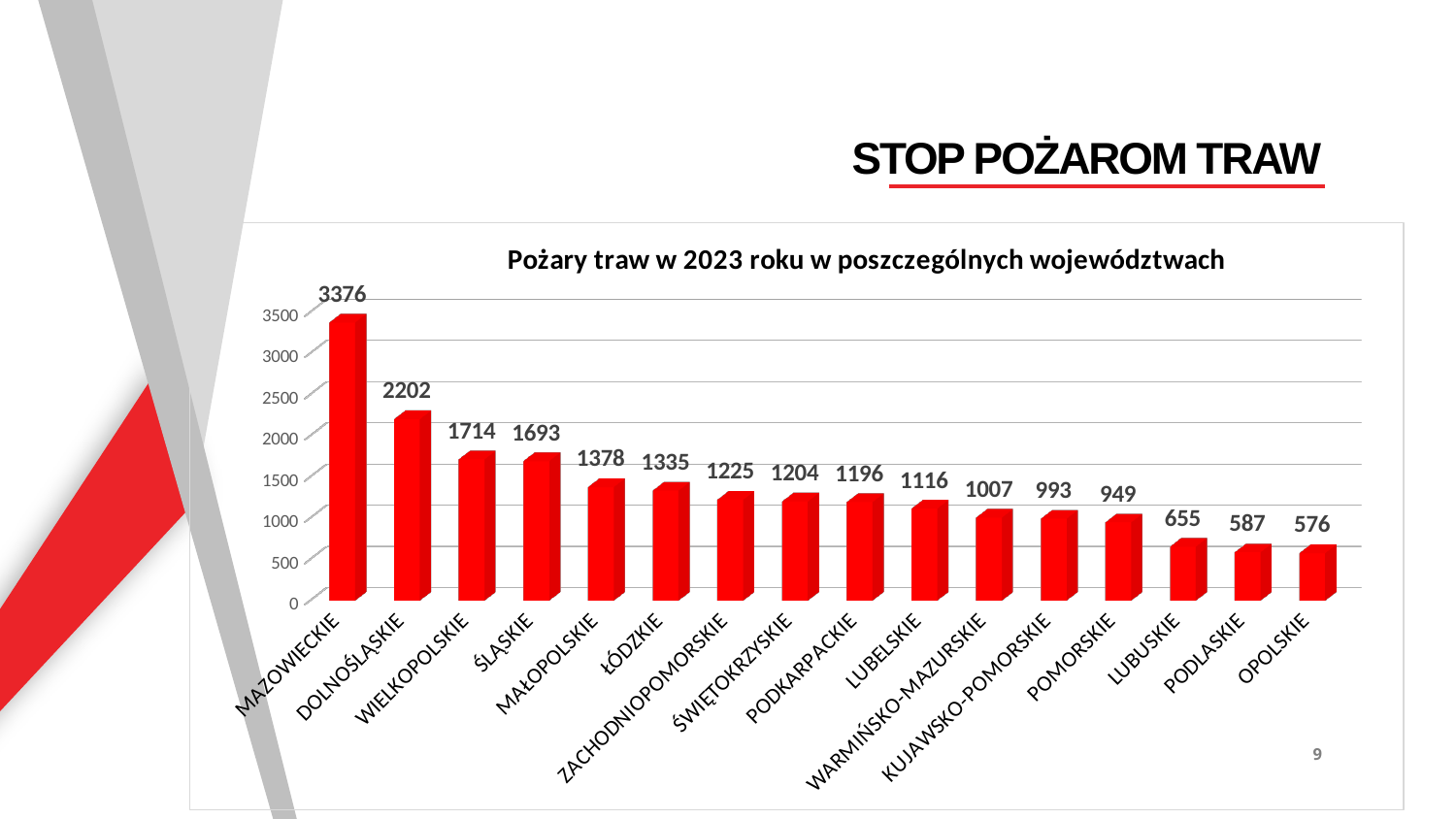
How many voivodeships are shown in the chart? 16 Which voivodeship has the lowest value? OPOLSKIE What is the value for POMORSKIE? 949 Is the value for KUJAWSKO-POMORSKIE greater or less than 1000? less What is the title of the chart? Pożary traw w 2023 roku w poszczególnych województwach Which voivodeship has the highest value? MAZOWIECKIE What is the difference between the values for LUBUSKIE and PODLASKIE? 68 What is the difference between the values for MAZOWIECKIE and DOLNOŚLĄSKIE? 1174 What kind of chart is shown on the slide? bar chart What is the value for MAZOWIECKIE? 3376 What is the value for ŚWIĘTOKRZYSKIE? 1204 Which is larger, the value for WIELKOPOLSKIE or the value for ŚLĄSKIE? WIELKOPOLSKIE